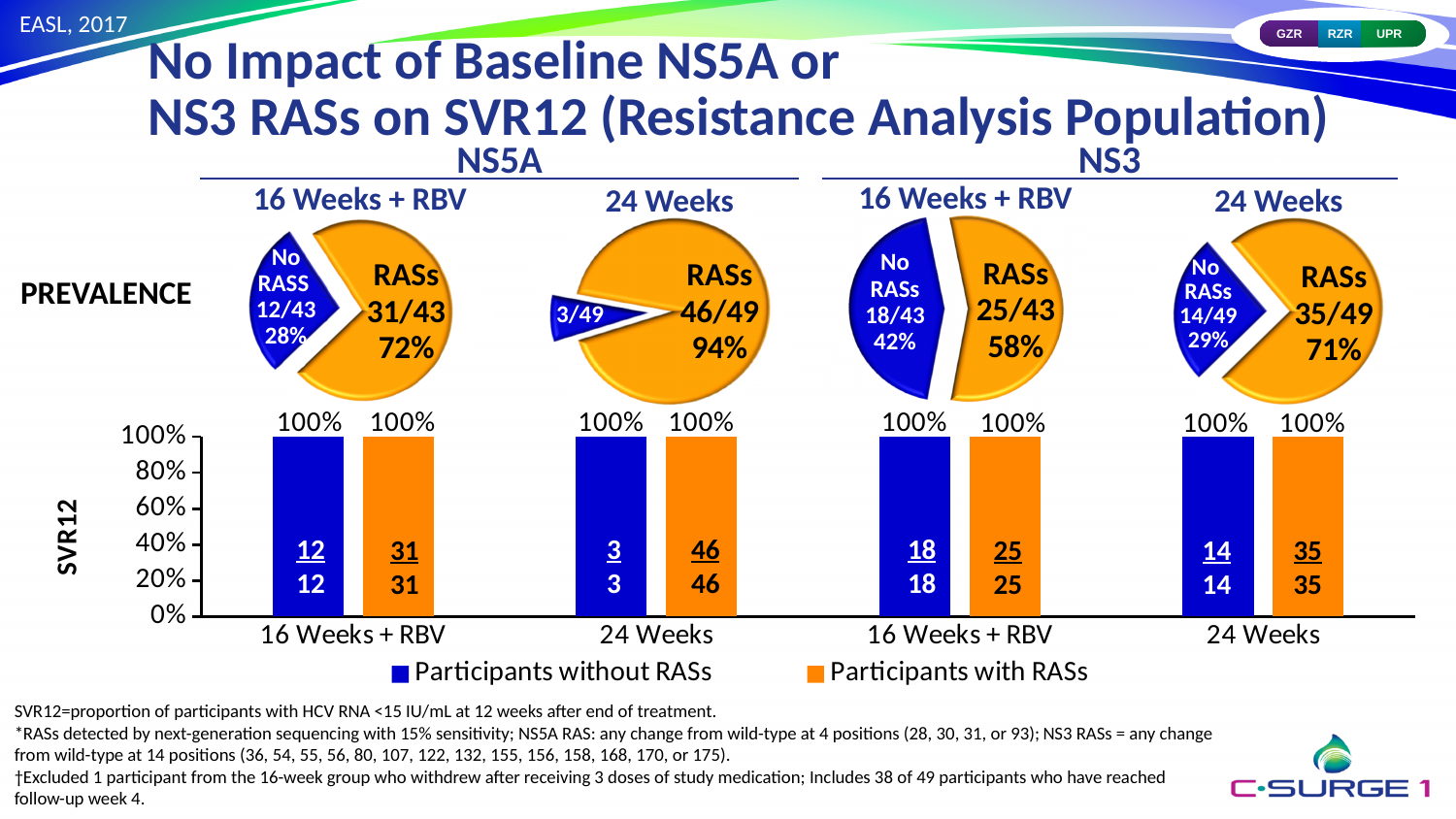
In the SVR12 bar chart, what fraction is printed on the bar for participants without RASs in the NS3 16 Weeks + RBV group? 18/18 In the NS3 16 Weeks + RBV prevalence pie chart, what fraction of participants had no RASs? 18/43 In the SVR12 bar chart, what is the SVR12 value for participants with RASs in the NS5A 24 Weeks group? 100% How many series does the legend of the SVR12 bar chart list? 2 In the NS5A 16 Weeks + RBV prevalence pie chart, what share of participants had RASs? 72% In the SVR12 bar chart, what fraction is printed on the bar for participants with RASs in the NS3 24 Weeks group? 35/35 How many category groups are shown along the x axis of the SVR12 bar chart? 4 In the SVR12 bar chart, which legend entry is shown in orange? Participants with RASs In the NS3 16 Weeks + RBV prevalence pie chart, which slice is larger: RASs or No RASs? RASs In the NS5A 24 Weeks prevalence pie chart, what share of participants had RASs? 94% In the NS3 24 Weeks prevalence pie chart, what share of participants had no RASs? 29% What kind of chart is the SVR12 chart at the bottom of the slide? Bar chart